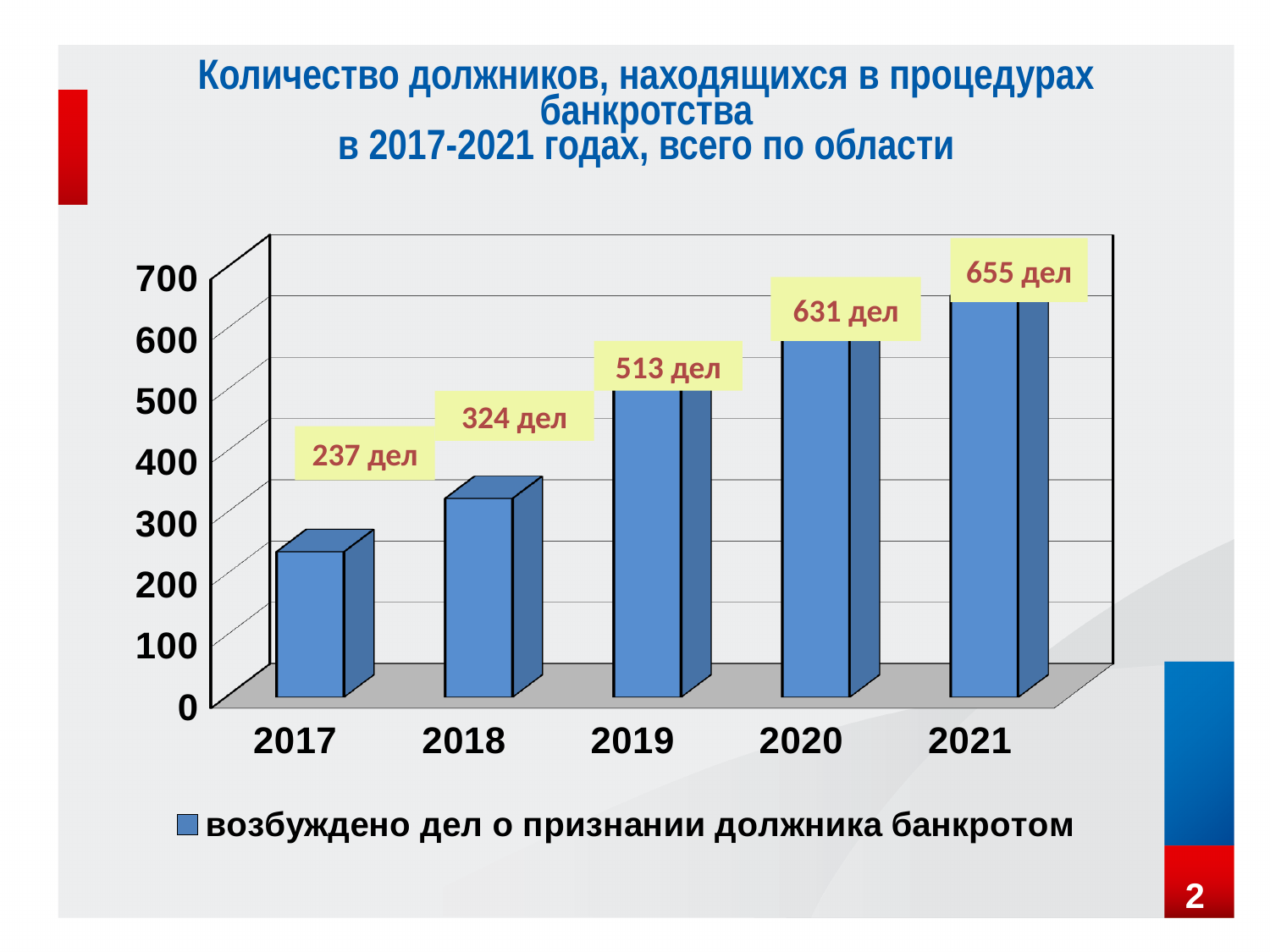
Which is larger, the value for 2018 or the value for 2019? 2019 What is the difference between the values for 2021 and 2020? 24 дел Which year has the highest value? 2021 What kind of chart is shown on the slide? bar chart What is the value for 2021? 655 дел What is the value for 2019? 513 дел Which year has the lowest value? 2017 How many years are shown on the x axis? 5 What is the value for 2017? 237 дел Do the values rise or fall from 2017 to 2021? rise Is the value for 2020 greater or less than 600? greater What is the difference between the values for 2019 and 2018? 189 дел